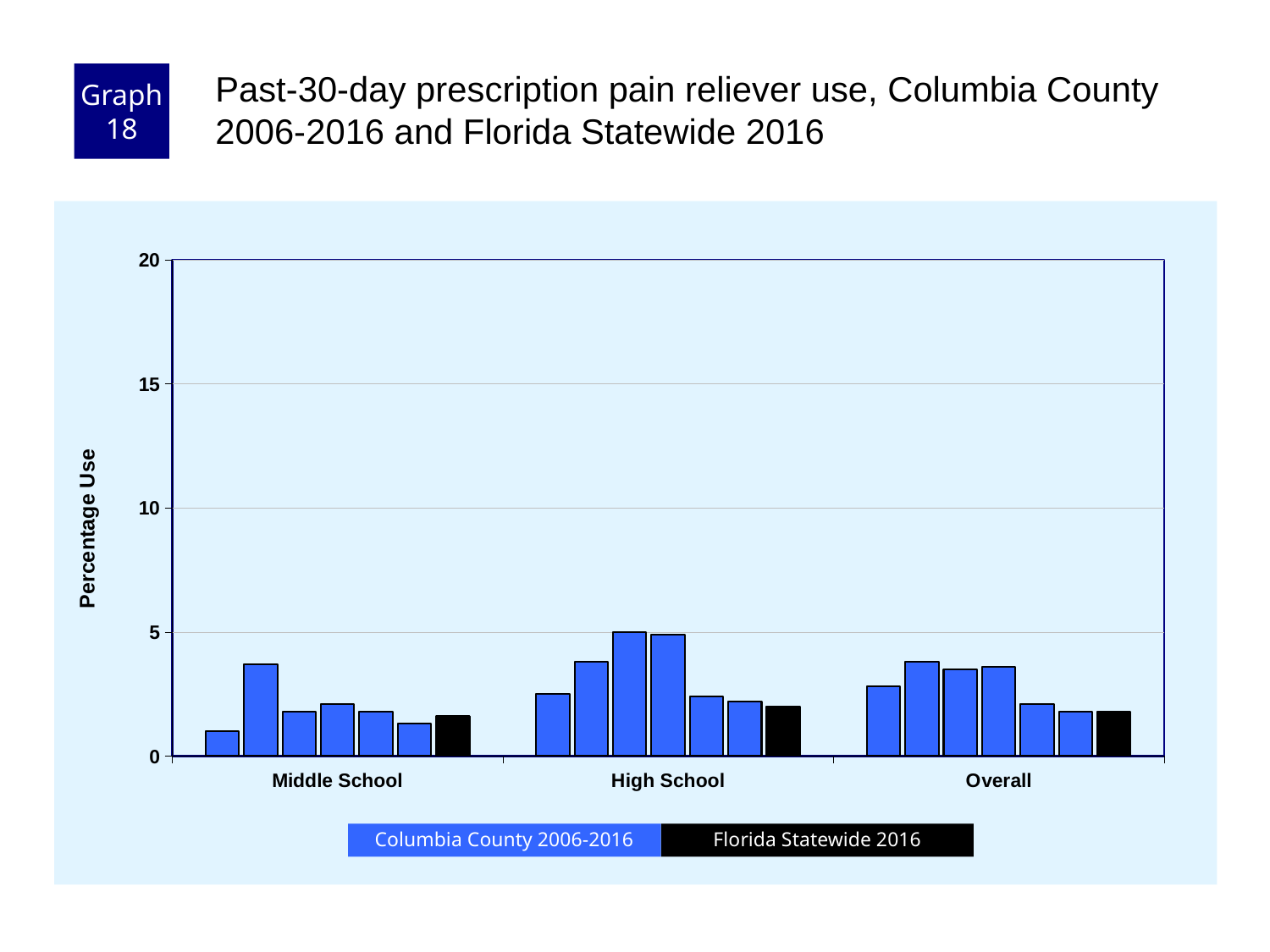
Which category group contains the tallest bar on the chart? High School Is the Florida Statewide 2016 value for Middle School greater or less than 5? less How many school-level categories are shown on the x axis? 3 How many bars are plotted in the High School group? 7 Are any of the plotted values greater than 10? No Is the tallest Columbia County bar in the Overall group greater or less than 5? less How many series does the legend list? 2 What kind of chart is shown on the slide? bar chart What is the label on the y axis? Percentage Use Which is larger: the tallest Columbia County bar for High School or the tallest Columbia County bar for Middle School? High School What colour represents Florida Statewide 2016 in the legend? black